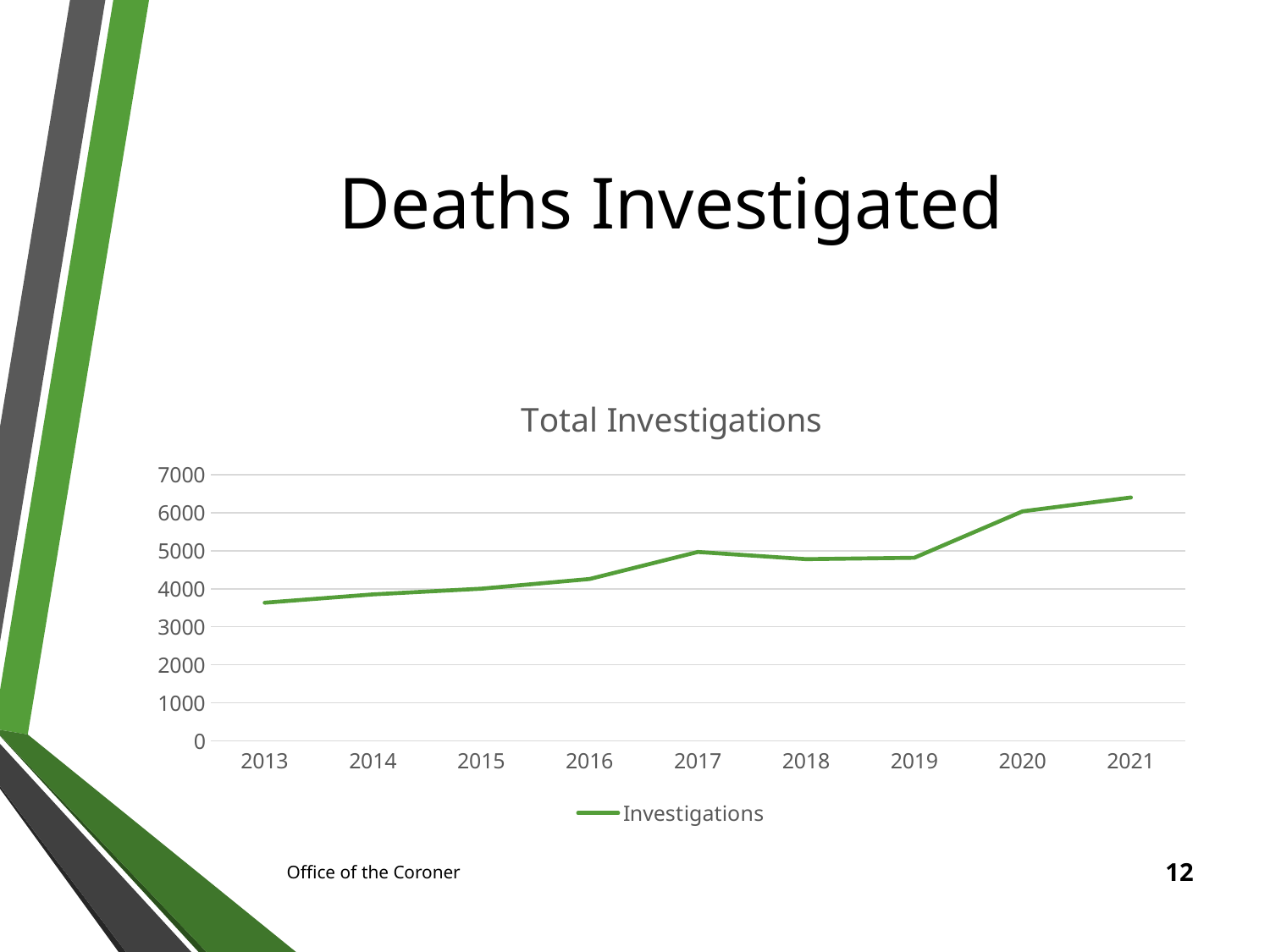
How many series does the legend of the Total Investigations chart list? 1 Which year has the highest value in the Total Investigations chart? 2021 What is the name of the series shown in the legend of the Total Investigations chart? Investigations How many years are plotted on the x axis of the Total Investigations chart? 9 What kind of chart is shown under the title "Total Investigations"? line chart Overall, do the values in the Total Investigations chart rise or fall from 2013 to 2021? rise In the Total Investigations chart, which year has the larger value, 2017 or 2016? 2017 Is the value for 2013 in the Total Investigations chart greater or less than 4000? less Which year has the lowest value in the Total Investigations chart? 2013 Is the value for 2018 in the Total Investigations chart greater or less than 5000? less In the Total Investigations chart, which year has the larger value, 2019 or 2020? 2020